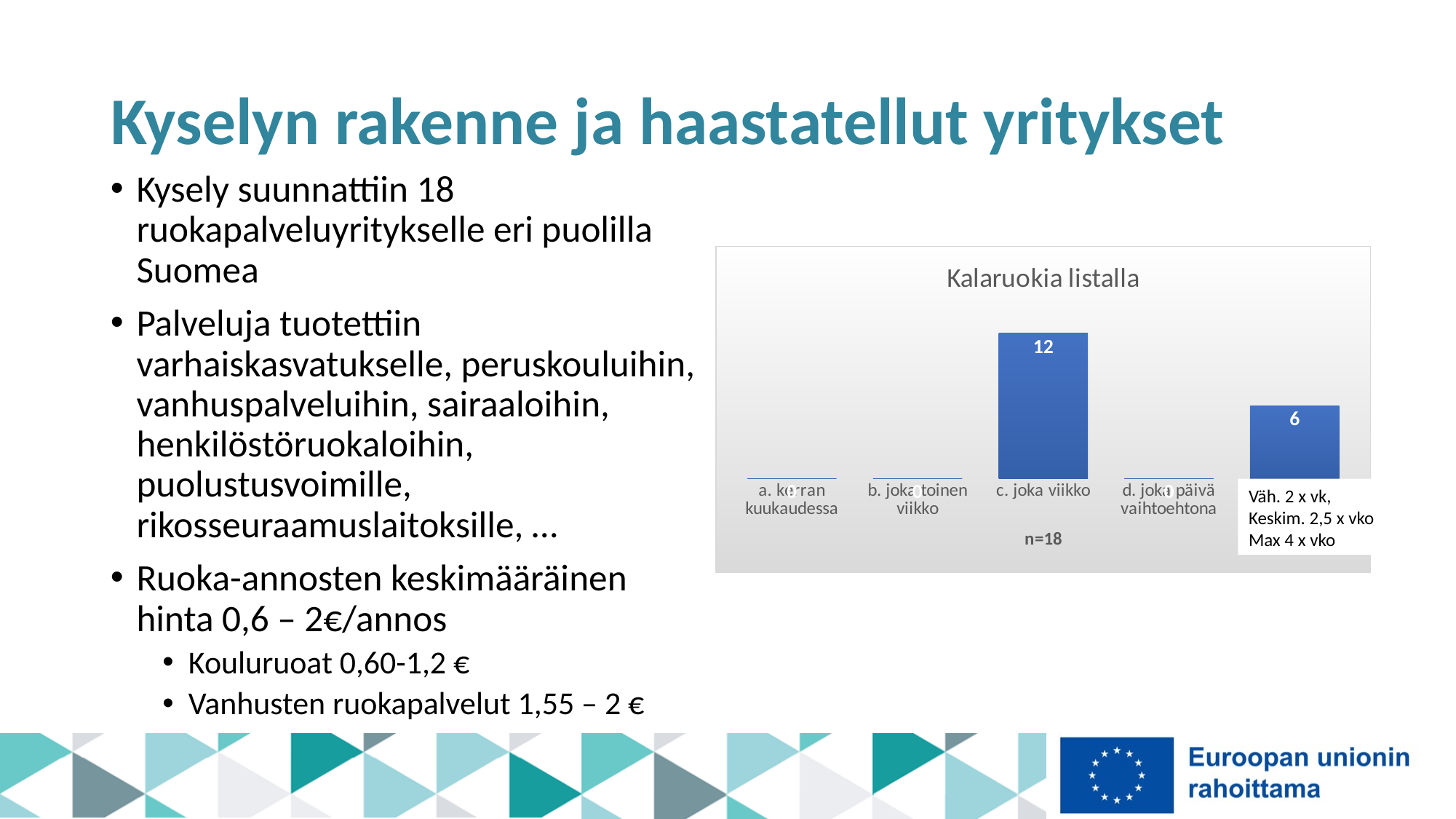
How many categories are shown along the x axis of the Kalaruokia listalla chart? 5 What is the value for 'c. joka viikko' in the Kalaruokia listalla chart? 12 In the Kalaruokia listalla chart, which is larger: the value for 'c. joka viikko' or the value of the rightmost bar? c. joka viikko What sample size is stated below the x axis of the Kalaruokia listalla chart? n=18 Is the value for 'c. joka viikko' in the Kalaruokia listalla chart greater or less than 10? greater What is the difference between the value for 'c. joka viikko' and the value of the rightmost bar in the Kalaruokia listalla chart? 6 What kind of chart is shown on the slide? bar chart Which category has the highest value in the Kalaruokia listalla chart? c. joka viikko What is the title of the chart on the slide? Kalaruokia listalla What is the value of the rightmost bar in the Kalaruokia listalla chart? 6